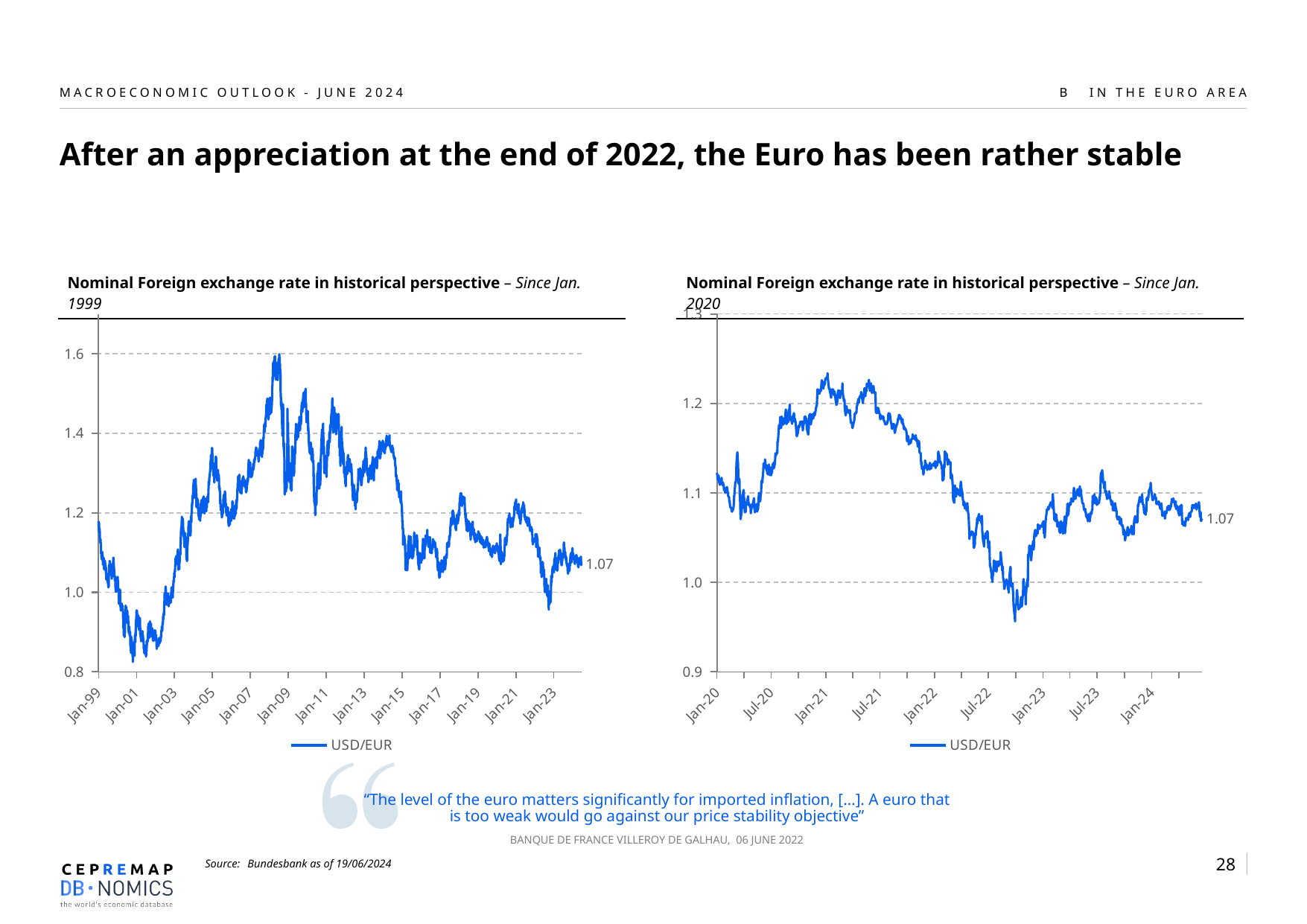
In the left chart (since Jan. 1999), what is the latest value labelled at the end of the USD/EUR line? 1.07 What is the name of the series shown in the legend of the right chart (since Jan. 2020)? USD/EUR In the right chart (since Jan. 2020), is the lowest value of USD/EUR, reached in late 2022, greater or less than 1.0? less What colour is the USD/EUR line in both charts? blue How many series does the legend of the left chart (since Jan. 1999) list? 1 In the left chart (since Jan. 1999), is the peak value of USD/EUR around Jan-09 greater or less than 1.4? greater In the left chart (since Jan. 1999), does the USD/EUR rate rise or fall between Jan-99 and Jan-01? fall In the right chart (since Jan. 2020), is the value of USD/EUR around Jan-21 greater or less than 1.2? greater What kind of chart is the left chart, 'Nominal Foreign exchange rate in historical perspective – Since Jan. 1999'? line chart In the right chart (since Jan. 2020), does the USD/EUR rate rise or fall between Jan-21 and Jul-22? fall In the right chart (since Jan. 2020), what is the latest value labelled at the end of the USD/EUR line? 1.07